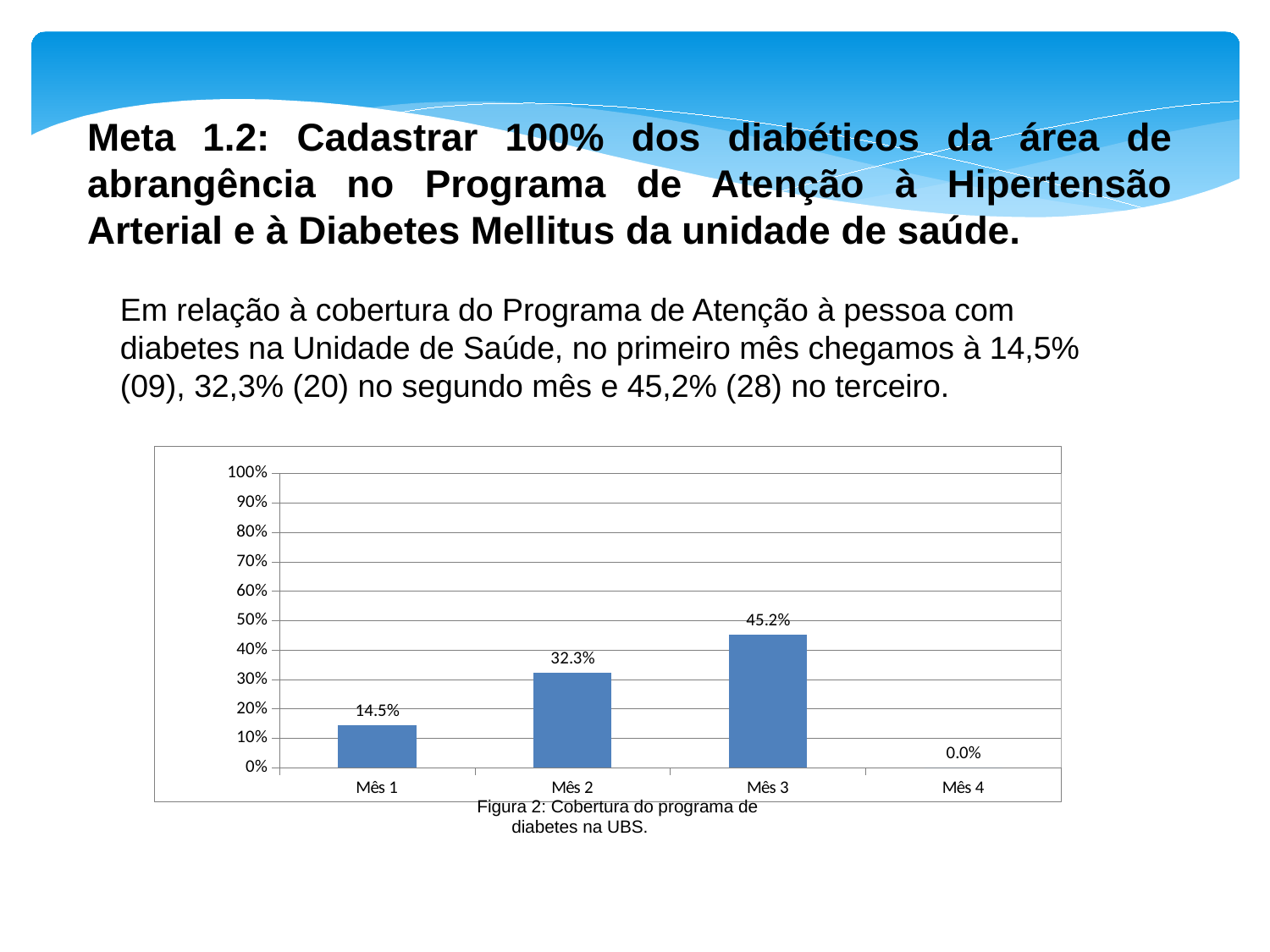
What is the difference between the values for Mês 3 and Mês 2? 12.9% Which month has the lowest value? Mês 4 Is the value for Mês 3 greater or less than 50%? less How many categories are shown on the x axis? 4 What is the difference between the values for Mês 2 and Mês 1? 17.8% What is the value for Mês 3? 45.2% What is the value for Mês 4? 0.0% What kind of chart is shown on the slide? bar chart Which month has the highest value? Mês 3 Which is larger, the value for Mês 1 or the value for Mês 2? Mês 2 What is the value for Mês 1? 14.5% What is the value for Mês 2? 32.3%